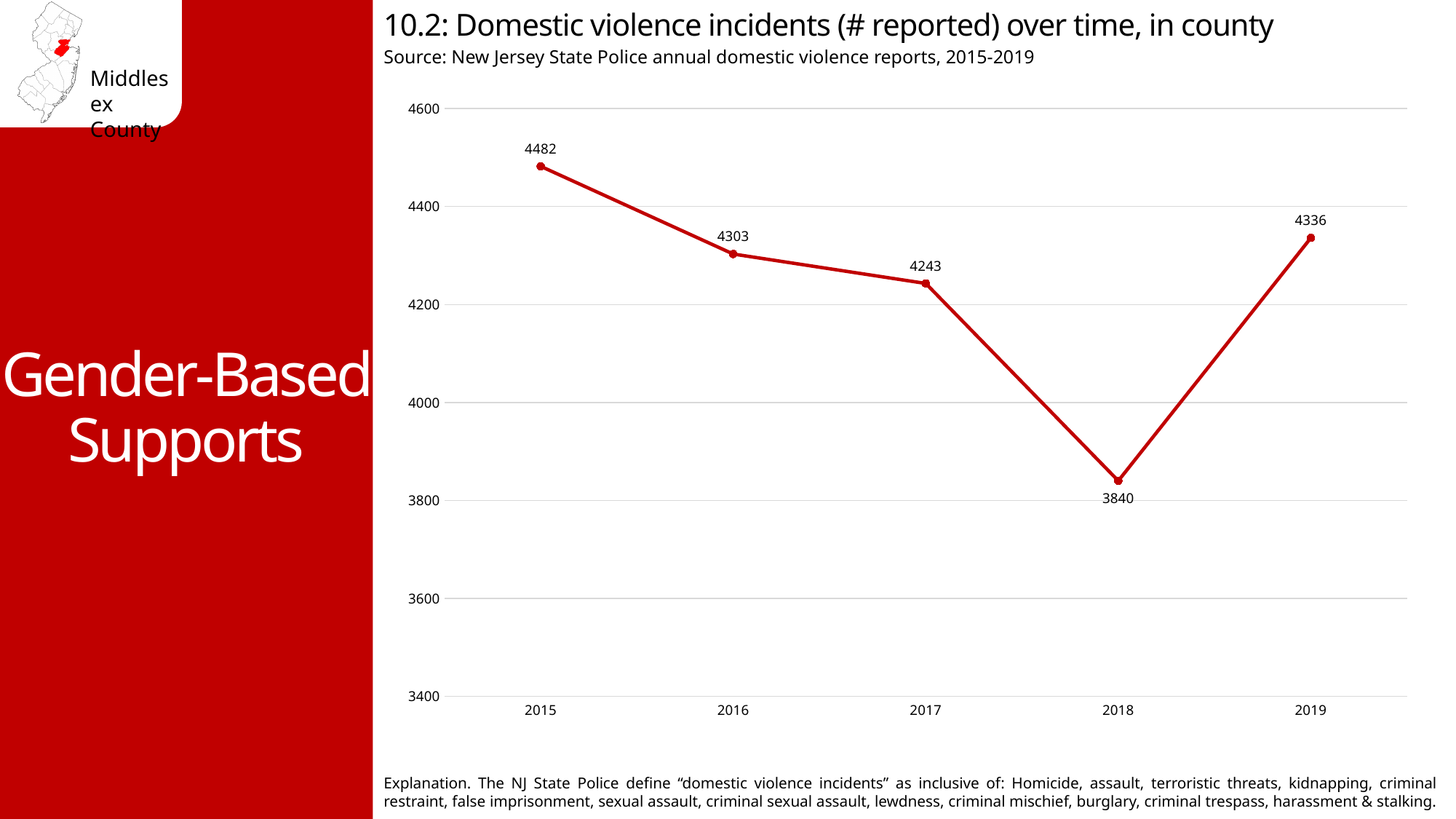
What is the value for 2018? 3840 How many domestic violence incidents were reported in 2015? 4482 Which year has the highest number of reported incidents? 2015 How many years are plotted on the chart? 5 What is the difference between the 2019 and 2018 values? 496 What is the difference between the 2015 and 2018 values? 642 Which year has the lowest number of reported incidents? 2018 Is the value for 2017 greater or less than 4200? greater What is the value for 2019? 4336 Which is larger, the value for 2016 or the value for 2019? 2019 Do the values rise or fall from 2015 to 2018? fall What kind of chart is shown? line chart